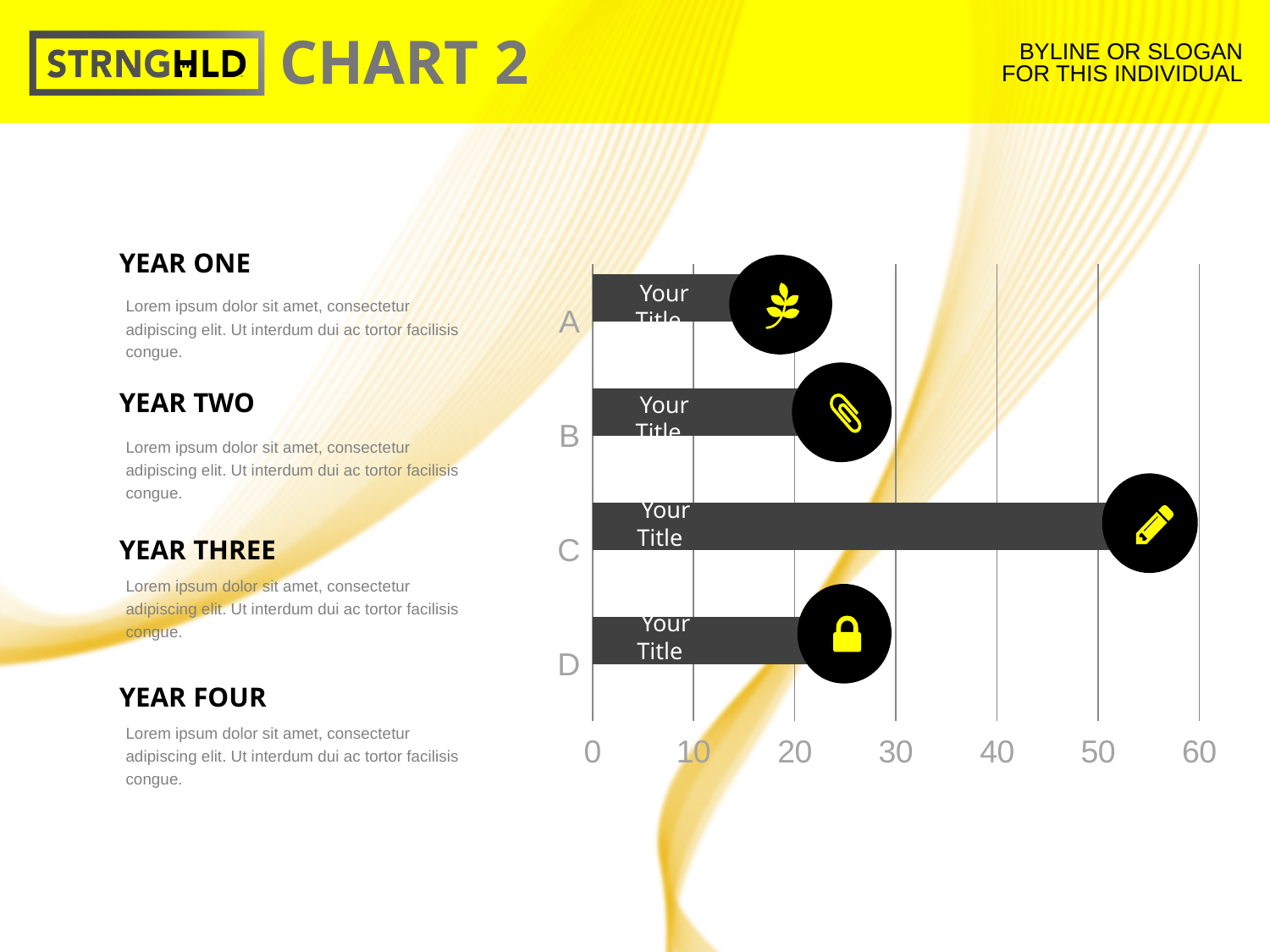
Is the value for A greater or less than 10? greater Which category has the lowest value? A How many categories are plotted on the chart? 4 Is the value for C greater or less than 40? greater Is the value for D greater or less than 40? less What are the category labels on the vertical axis, from top to bottom? A, B, C, D Which category has the highest value? C What is the highest value shown on the horizontal axis? 60 What kind of chart is shown on the slide? bar chart Which is larger, the value for C or the value for B? C